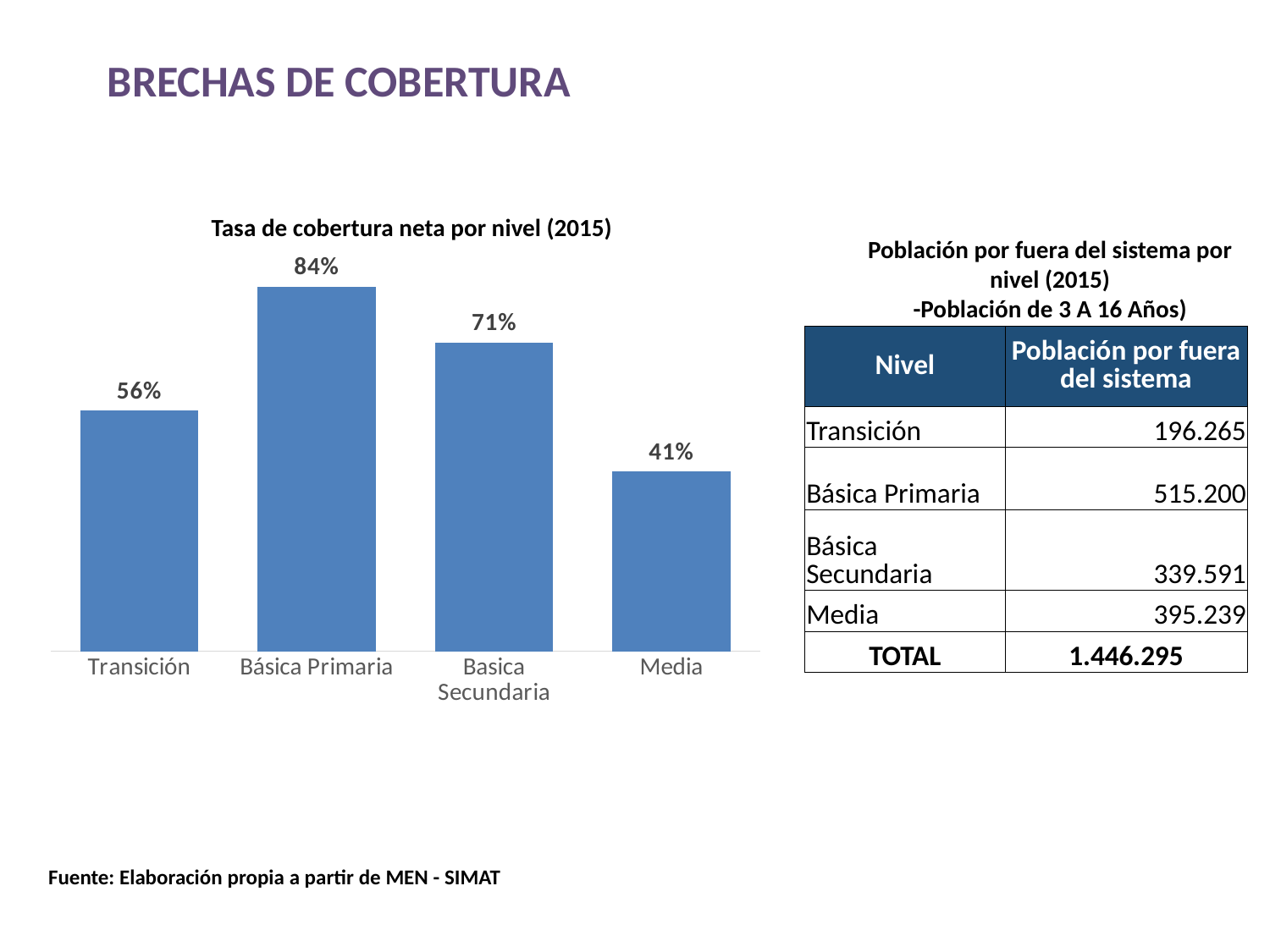
What kind of chart is shown on the slide? Bar chart How many categories are shown in the chart? 4 What is the value for Básica Primaria in the chart? 84% Which level has the highest net coverage rate in the chart? Básica Primaria What is the value for Transición in the chart? 56% What is the difference between the values for Básica Primaria and Media? 43% Which is larger, the value for Transición or the value for Media? Transición What is the title of the chart? Tasa de cobertura neta por nivel (2015) What is the value for Media in the chart? 41% Which level has the lowest net coverage rate in the chart? Media What is the value for Basica Secundaria in the chart? 71% What is the difference between the values for Basica Secundaria and Transición? 15%